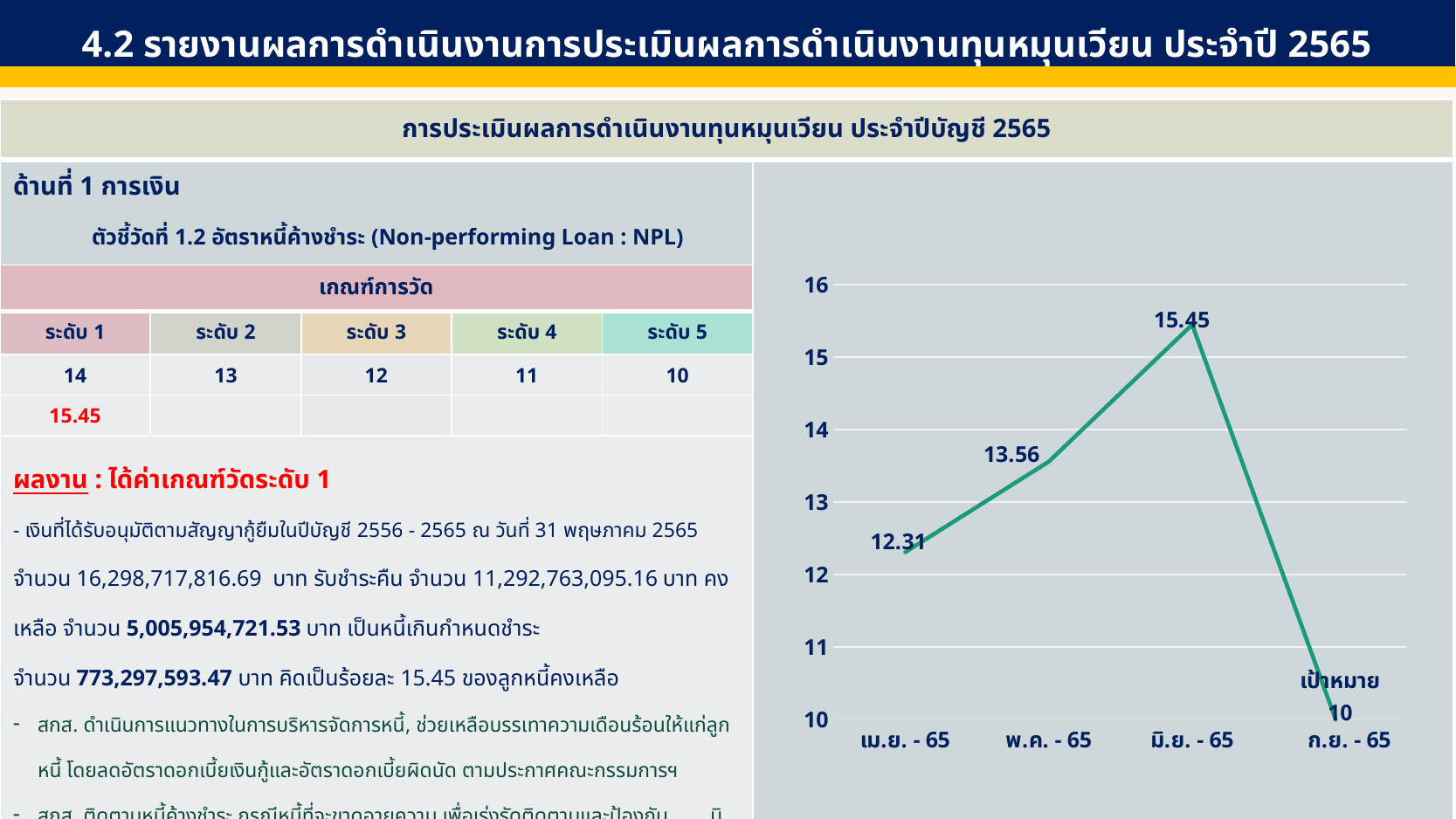
Which category has the lowest value on the line chart? ก.ย. - 65 What is the difference between the values for มิ.ย. - 65 and พ.ค. - 65? 1.89 How many data points are plotted on the line chart? 4 What label is written next to the last point on the line chart? เป้าหมาย What is the value plotted for ก.ย. - 65? 10 Which category has the highest value on the line chart? มิ.ย. - 65 What is the difference between the values for พ.ค. - 65 and เม.ย. - 65? 1.25 What type of chart is shown on the right side of the slide? line chart What is the value plotted for พ.ค. - 65? 13.56 What is the value plotted for มิ.ย. - 65? 15.45 What is the value plotted for เม.ย. - 65? 12.31 Which is larger, the value for เม.ย. - 65 or the value for พ.ค. - 65? พ.ค. - 65